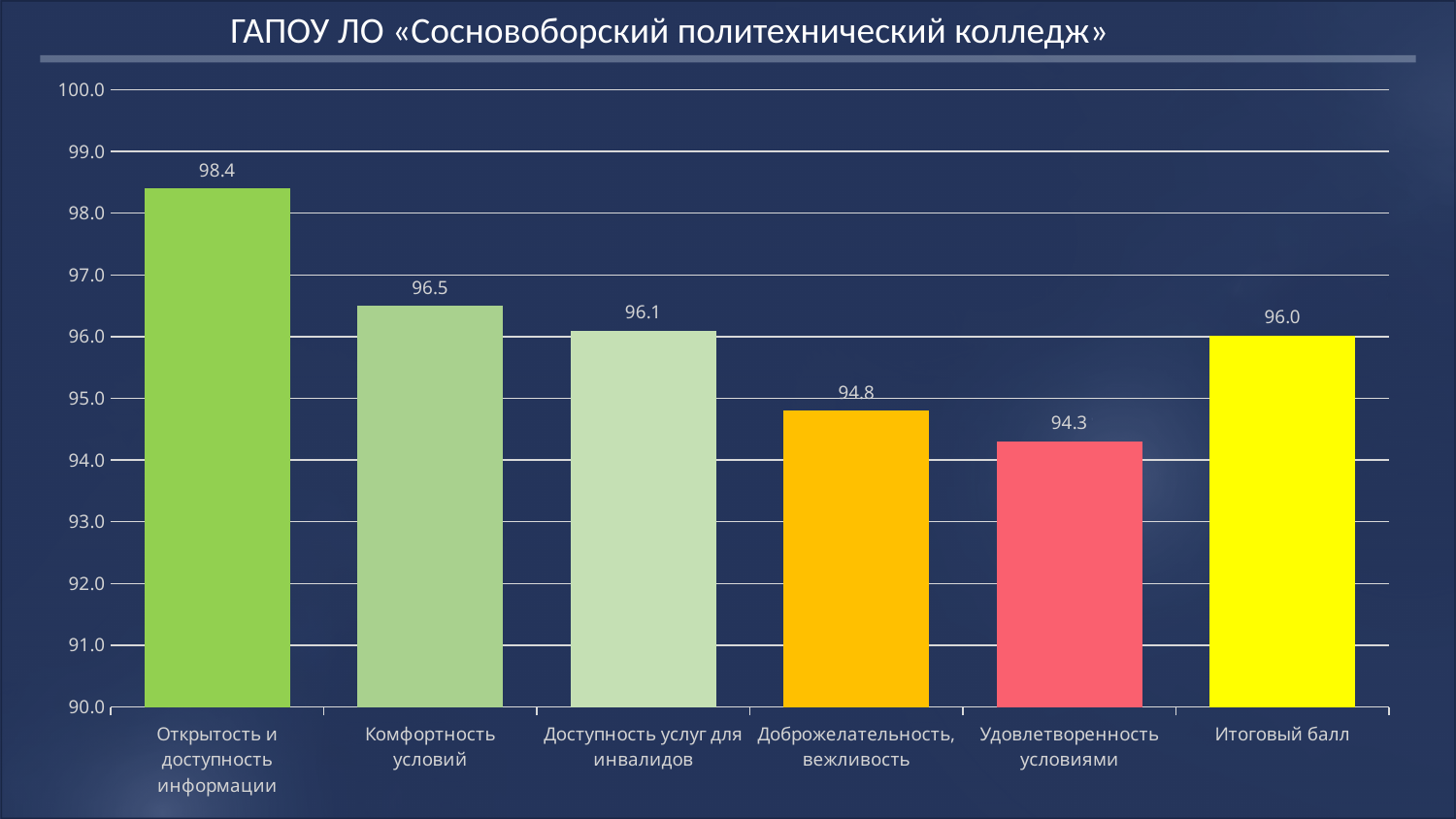
What is the value for «Итоговый балл»? 96.0 Is the value for «Доброжелательность, вежливость» greater or less than 95.0? less What is the difference between «Комфортность условий» and «Доступность услуг для инвалидов»? 0.4 Which category has the lowest value? Удовлетворенность условиями What is the difference between «Открытость и доступность информации» and «Удовлетворенность условиями»? 4.1 What is the value for «Открытость и доступность информации»? 98.4 What is the value for «Удовлетворенность условиями»? 94.3 Which category has the highest value? Открытость и доступность информации What is the title of the chart? ГАПОУ ЛО «Сосновоборский политехнический колледж» How many categories are shown on the chart? 6 What kind of chart is shown on the slide? bar chart Which is larger, «Доброжелательность, вежливость» or «Доступность услуг для инвалидов»? Доступность услуг для инвалидов